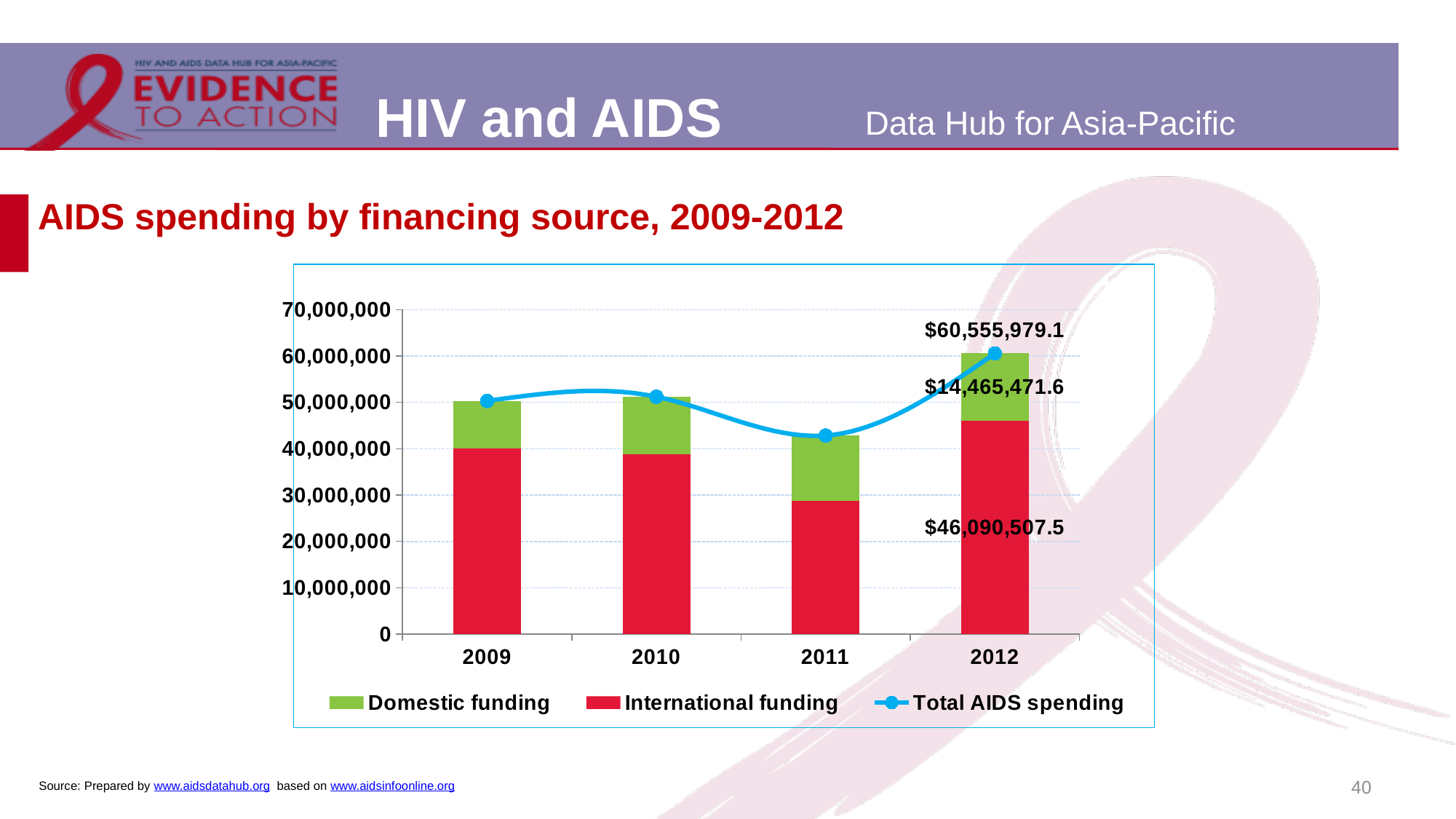
What is the total AIDS spending shown for 2012? $60,555,979.1 In 2012, how much larger is international funding than domestic funding? $31,625,035.9 What is the domestic funding value labelled for 2012? $14,465,471.6 What kind of chart is used to show domestic and international funding? Stacked bar chart Is the international funding for 2009 greater or less than 30,000,000? greater How many years are shown on the x axis? 4 In 2012, which is larger: domestic funding or international funding? International funding Is the total AIDS spending for 2011 greater or less than 50,000,000? less How many series does the legend list? 3 Which year has the highest total AIDS spending? 2012 Which year has the lowest total AIDS spending? 2011 What is the international funding value labelled for 2012? $46,090,507.5